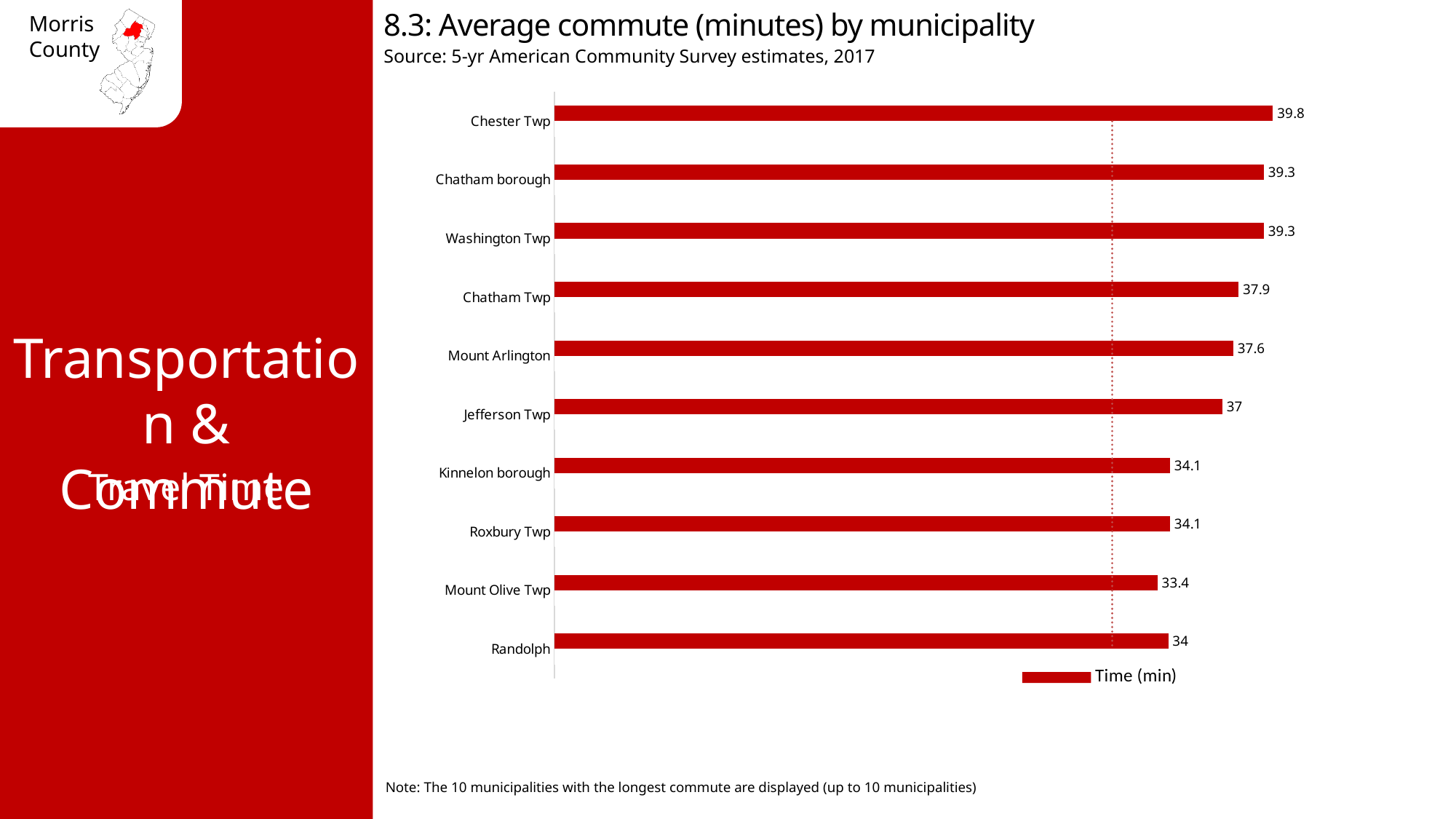
What type of chart is used to show average commute by municipality? Bar chart What is the average commute time for Randolph? 34 Which has a longer average commute, Jefferson Twp or Kinnelon borough? Jefferson Twp What is the average commute time for Chester Twp? 39.8 What is the average commute time for Mount Olive Twp? 33.4 Which municipality has the highest average commute time? Chester Twp What is the difference in average commute time between Chester Twp and Randolph? 5.8 How many municipalities are shown in the chart? 10 What is the difference in average commute time between Chatham Twp and Jefferson Twp? 0.9 What is the name of the series shown in the chart legend? Time (min) Which municipality has the lowest average commute time? Mount Olive Twp What is the average commute time for Mount Arlington? 37.6